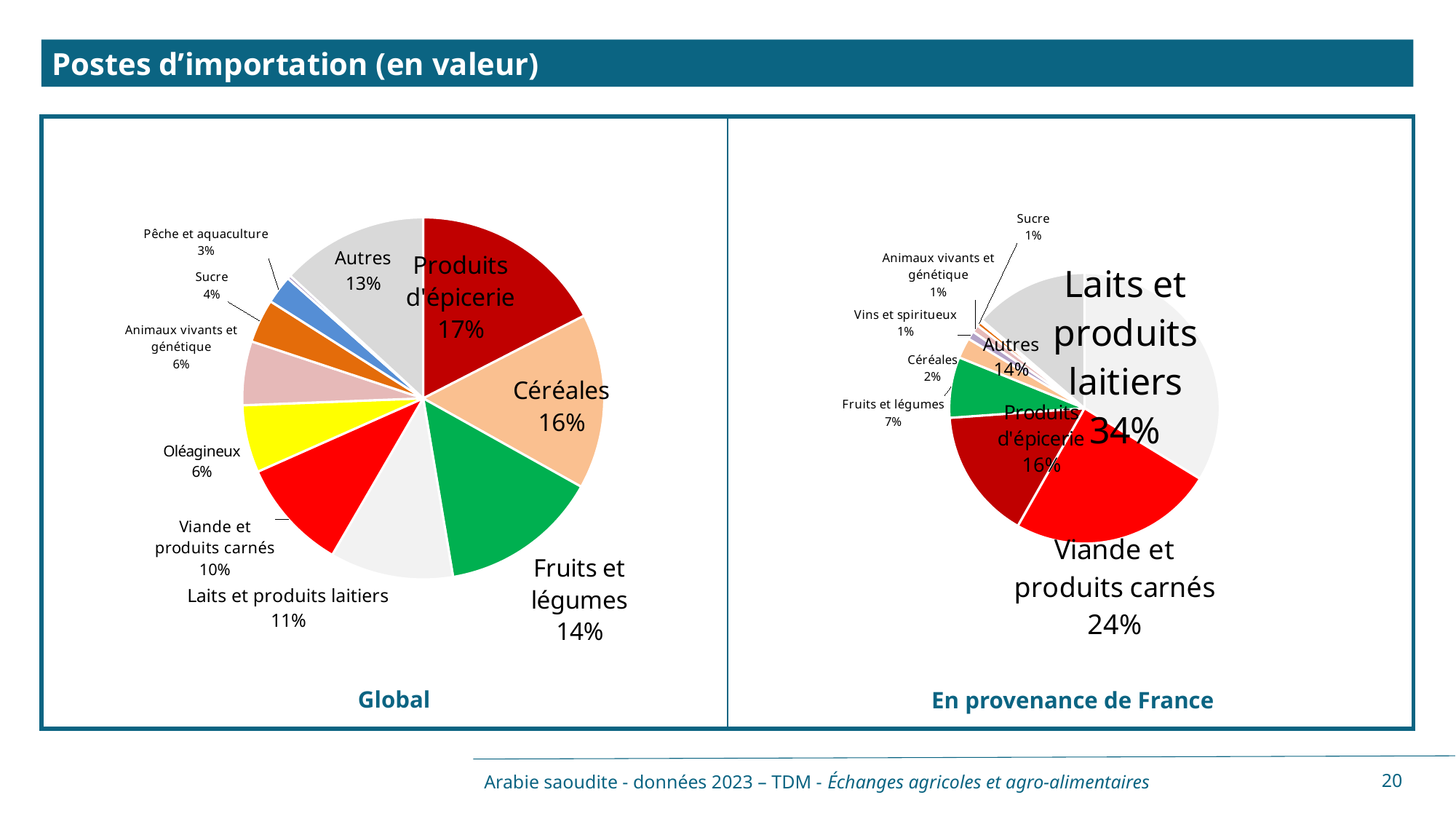
In the 'Global' pie chart, how many categories are shown? 10 In the 'Global' pie chart, what is the difference between the shares of Laits et produits laitiers and Viande et produits carnés? 1 percentage point In the 'En provenance de France' pie chart, what share do Laits et produits laitiers represent? 34% In the 'En provenance de France' pie chart, what share do Viande et produits carnés represent? 24% In the 'En provenance de France' pie chart, which category has the largest share? Laits et produits laitiers In the 'Global' pie chart, what share do Produits d'épicerie represent? 17% In the 'Global' pie chart, which category has the largest share? Produits d'épicerie In the 'En provenance de France' pie chart, what is the difference between the shares of Laits et produits laitiers and Viande et produits carnés? 10 percentage points In the 'En provenance de France' pie chart, which is larger: Produits d'épicerie or Fruits et légumes? Produits d'épicerie In the 'Global' pie chart, which category has the smallest share? Pêche et aquaculture What type of chart is used on this slide? Pie chart In the 'Global' pie chart, what share do Céréales represent? 16%